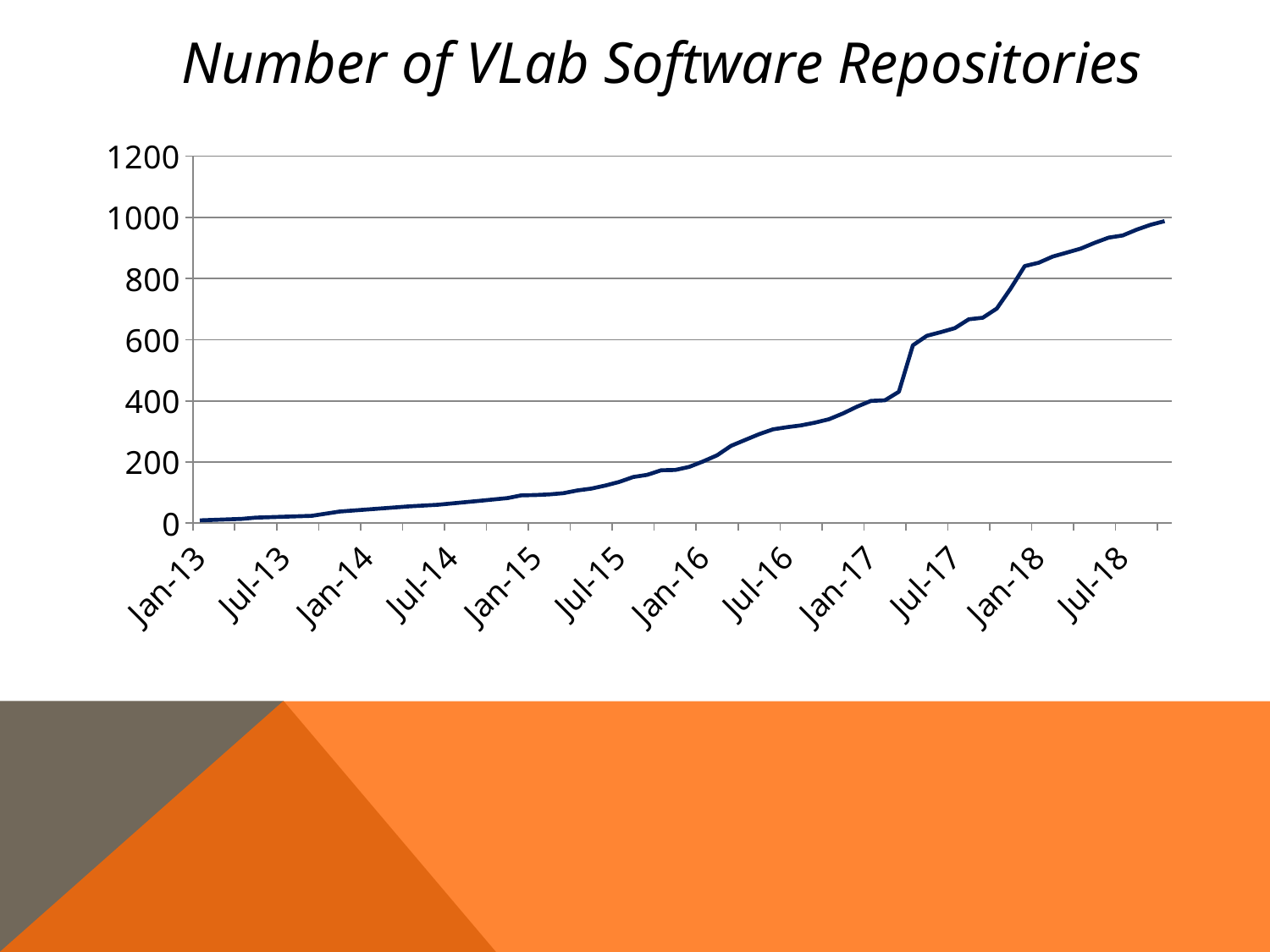
At which x-axis label is the value lowest? Jan-13 Is the value at Jan-18 greater or less than 800? greater How many date labels are shown on the x axis? 12 Which is larger, the value at Jan-17 or the value at Jan-16? Jan-17 Is the value at Jul-18 greater or less than 1000? less What is the highest value shown on the y axis? 1200 Is the value at Jul-16 greater or less than 400? less What is the title of the chart? Number of VLab Software Repositories Do the values rise or fall from Jan-13 to Jul-18? rise What kind of chart is shown on the slide? line chart